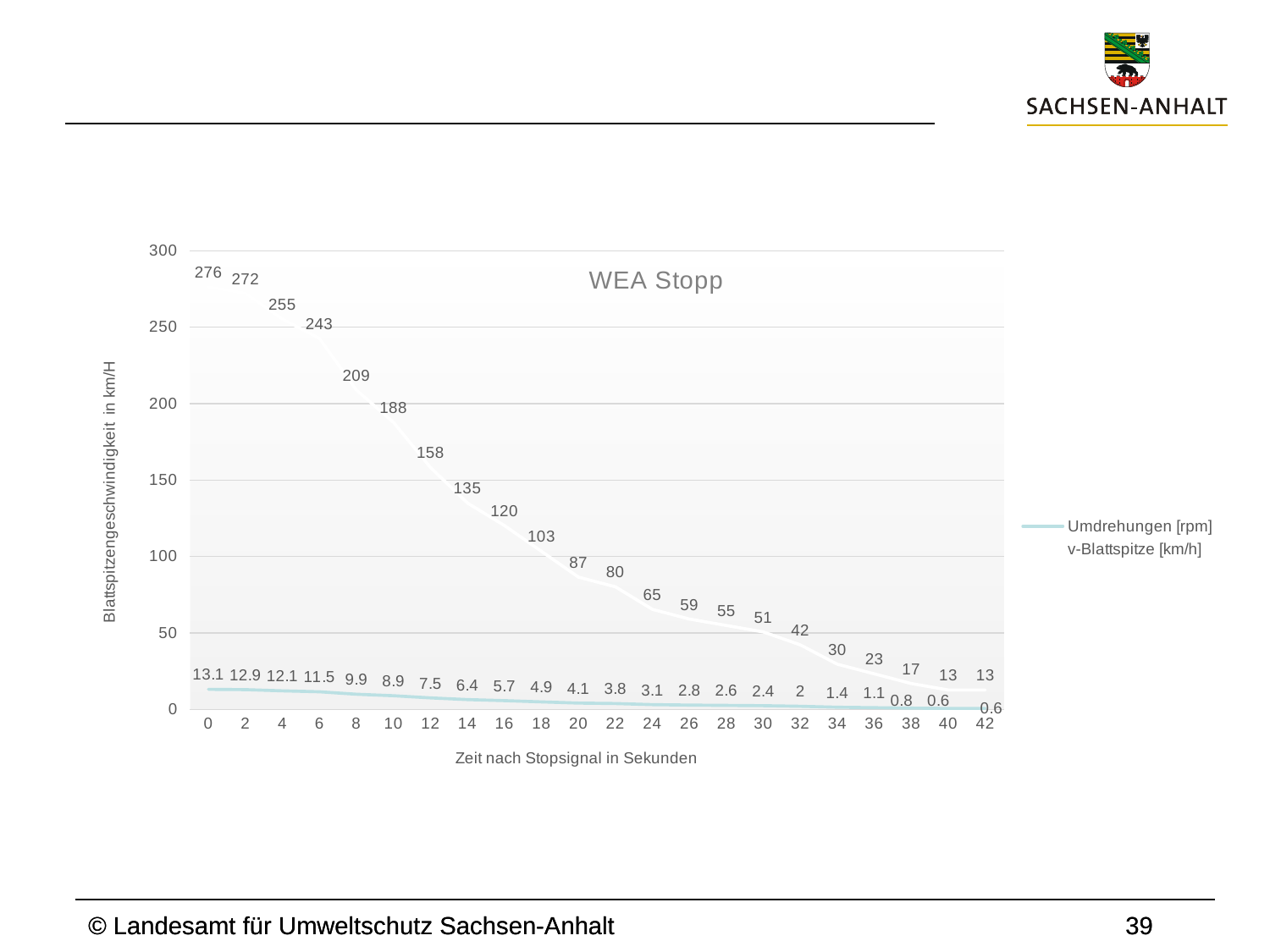
What kind of chart is shown on the slide? line chart What is the v-Blattspitze [km/h] value at 20 seconds? 87 Which is larger: the v-Blattspitze [km/h] value at 8 seconds or at 12 seconds? 8 seconds Do the v-Blattspitze [km/h] values rise or fall as time after the stop signal increases? fall How many series does the legend list? 2 How many time points are plotted along the x axis? 22 What is the difference between the v-Blattspitze [km/h] values at 0 seconds and 2 seconds? 4 What is the Umdrehungen [rpm] value at 10 seconds? 8.9 At which time in seconds is the v-Blattspitze [km/h] value highest? 0 What is the v-Blattspitze [km/h] value at 0 seconds? 276 What is the lowest Umdrehungen [rpm] value shown? 0.6 What is the title of the chart? WEA Stopp